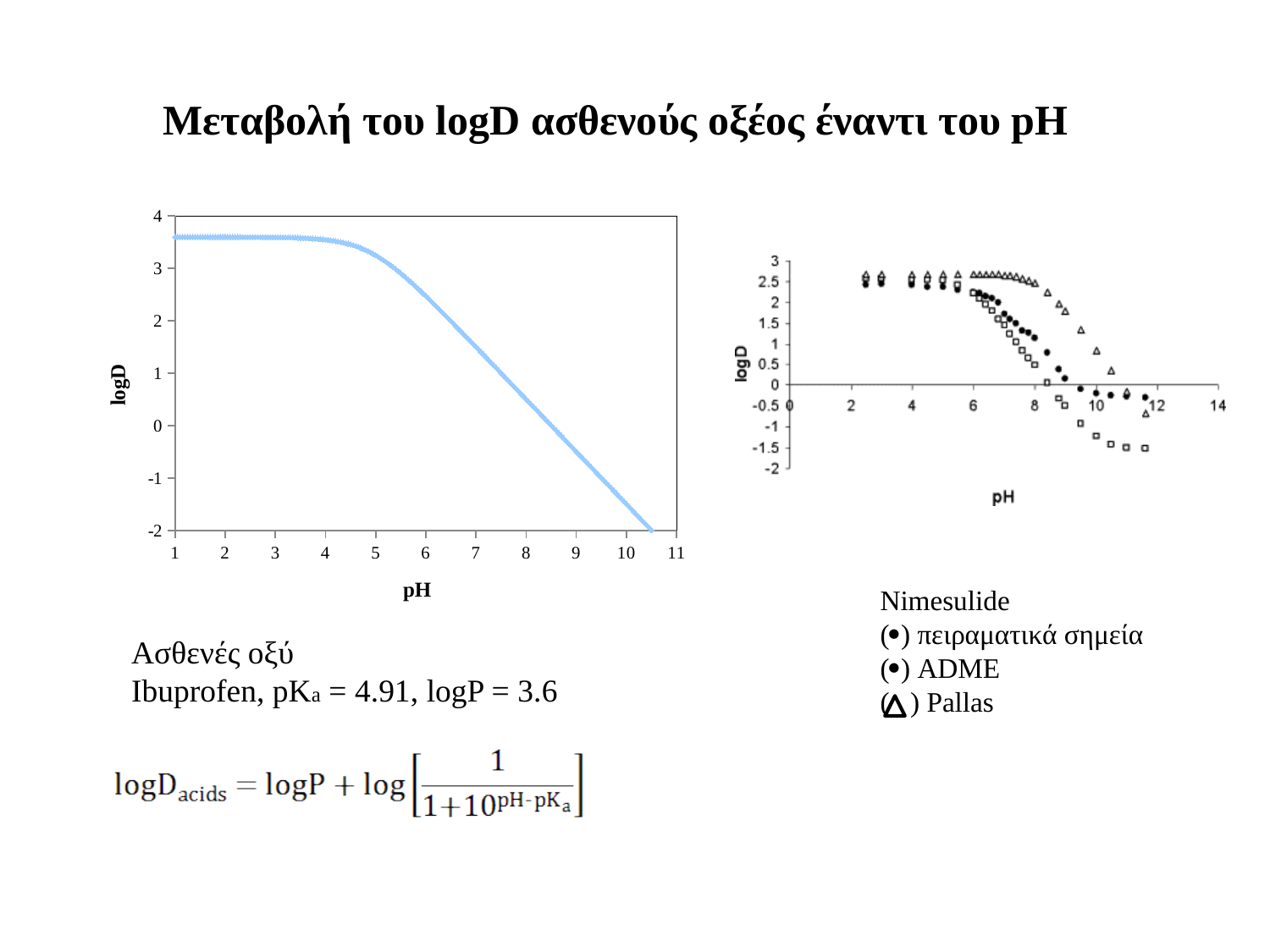
In the left chart, is the logD value at pH 9 greater or less than 0? less How many series does the legend of the right chart (Nimesulide) list? 3 Which compound is plotted in the right chart? Nimesulide In the left chart, does logD rise or fall as pH increases from 5 to 11? fall What is the label of the y axis of the left chart? logD What kind of chart is the left chart (logD vs pH for ibuprofen)? line chart In the right chart (Nimesulide), is the Pallas (triangle) value at pH 6 greater or less than 2? greater In the left chart, is the logD value at pH 10 greater or less than -1? less In the right chart (Nimesulide), does logD rise or fall as pH increases from 6 to 12? fall